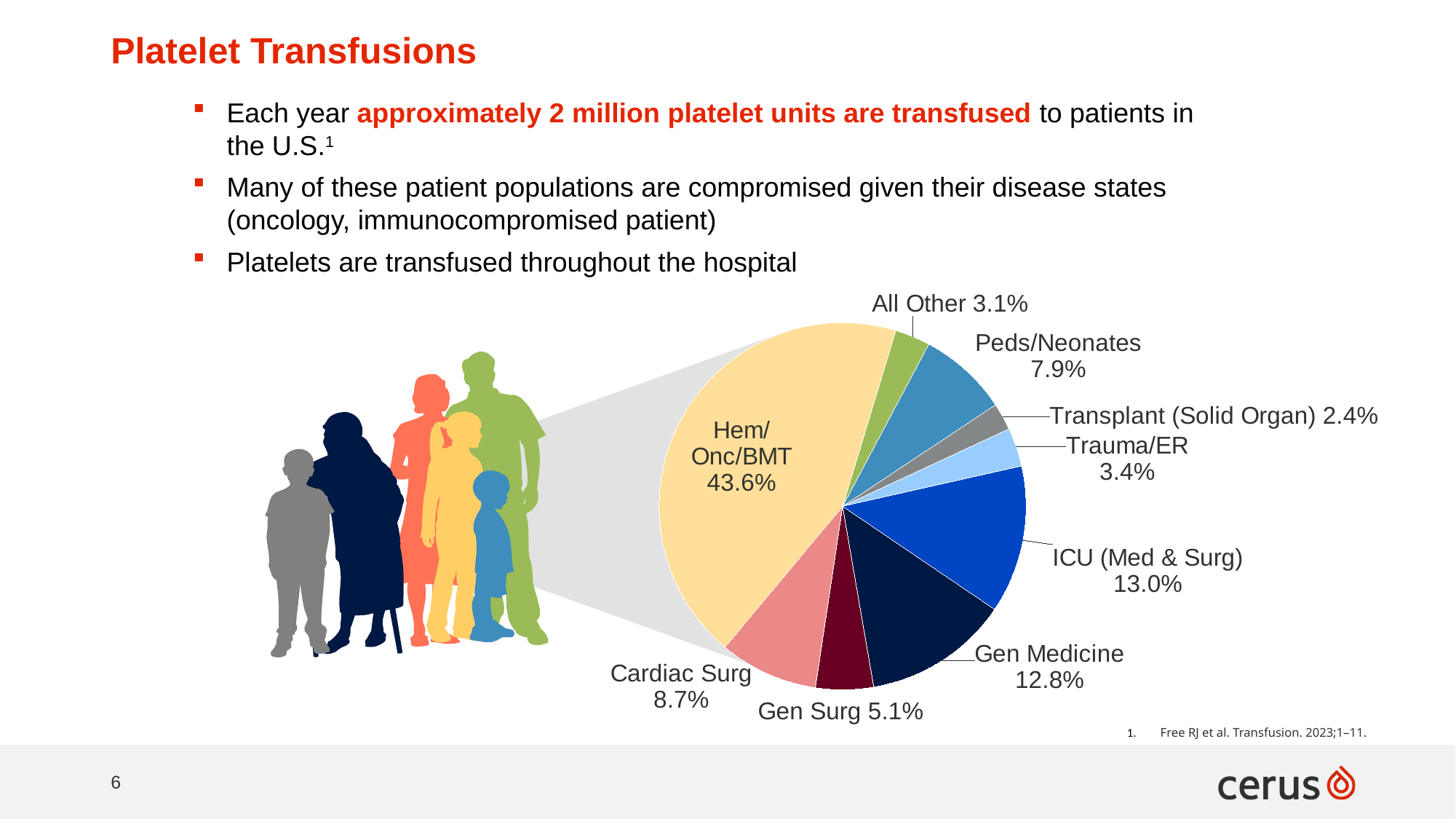
What is the combined share of Trauma/ER and All Other? 6.5% Which is larger, the Gen Medicine slice or the Peds/Neonates slice? Gen Medicine What percentage is shown for ICU (Med & Surg)? 13.0% What percentage is shown for Transplant (Solid Organ)? 2.4% Which category has the smallest slice of the pie? Transplant (Solid Organ) How many slices does the pie chart have? 9 What is the difference between the Cardiac Surg and Gen Surg percentages? 3.6% What share of platelet transfusions goes to Hem/Onc/BMT? 43.6% What colour is the Hem/Onc/BMT slice? Light yellow What percentage is shown for Peds/Neonates? 7.9% What kind of chart is shown on the slide? Pie chart Which category has the largest slice of the pie? Hem/Onc/BMT